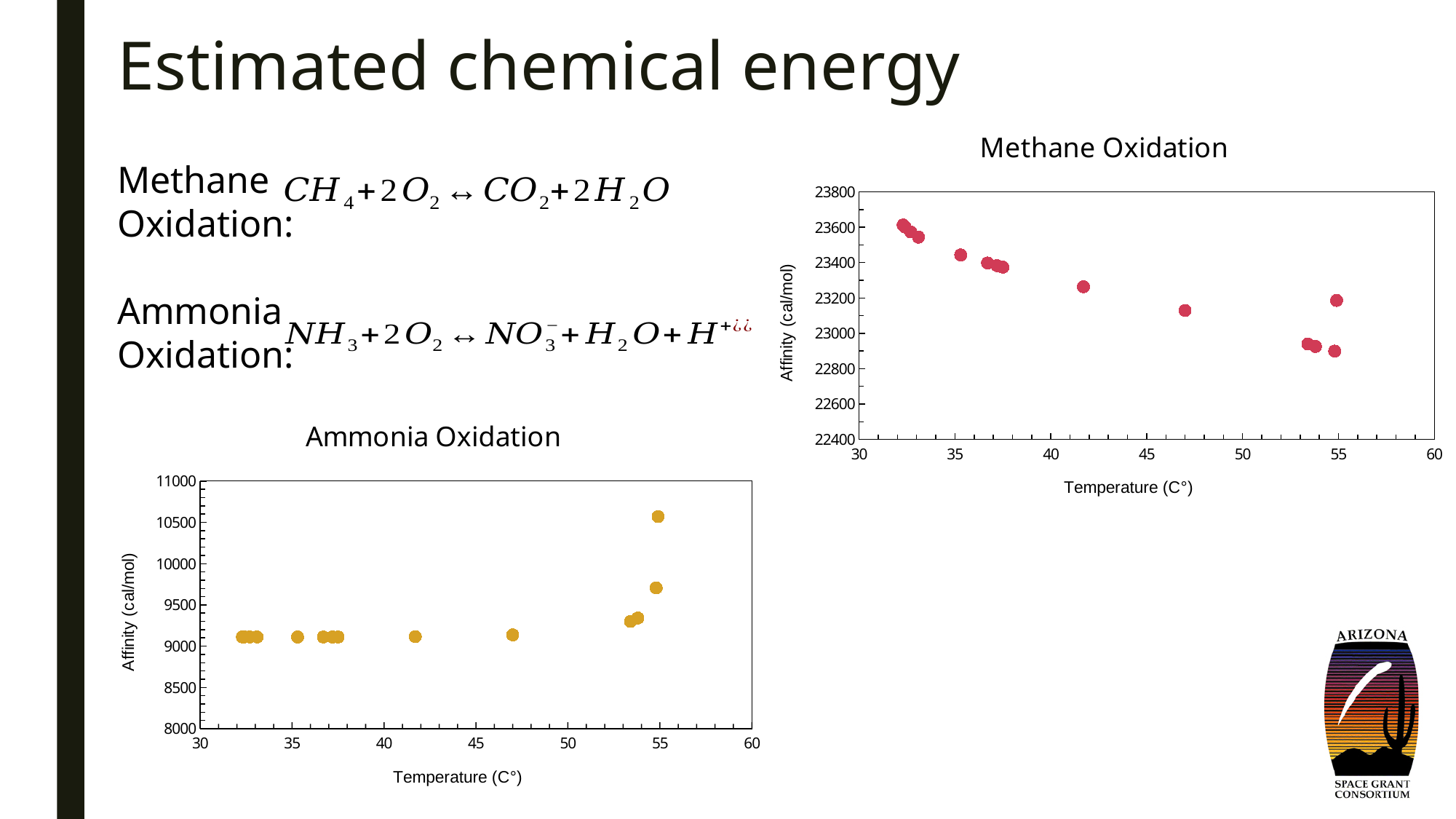
In the Methane Oxidation chart, are the affinity values near 32 °C greater or less than 23400 cal/mol? greater In the Ammonia Oxidation chart, do the affinity values rise or fall as temperature increases? rise What is the x-axis label of the Ammonia Oxidation chart? Temperature (C°) What is the y-axis label of the Methane Oxidation chart? Affinity (cal/mol) What kind of chart is the Ammonia Oxidation chart? scatter chart In the Methane Oxidation chart, is the lowest affinity value (near 55 °C) greater or less than 23000 cal/mol? less What kind of chart is the Methane Oxidation chart? scatter chart In the Ammonia Oxidation chart, are the affinity values near 32 °C greater or less than 9500 cal/mol? less In the Ammonia Oxidation chart, which has the higher affinity: the highest point near 55 °C or the points near 32 °C? the highest point near 55 °C In the Methane Oxidation chart, do the affinity values rise or fall as temperature increases? fall In the Methane Oxidation chart, which has the higher affinity: the points near 32 °C or the lowest point near 55 °C? the points near 32 °C